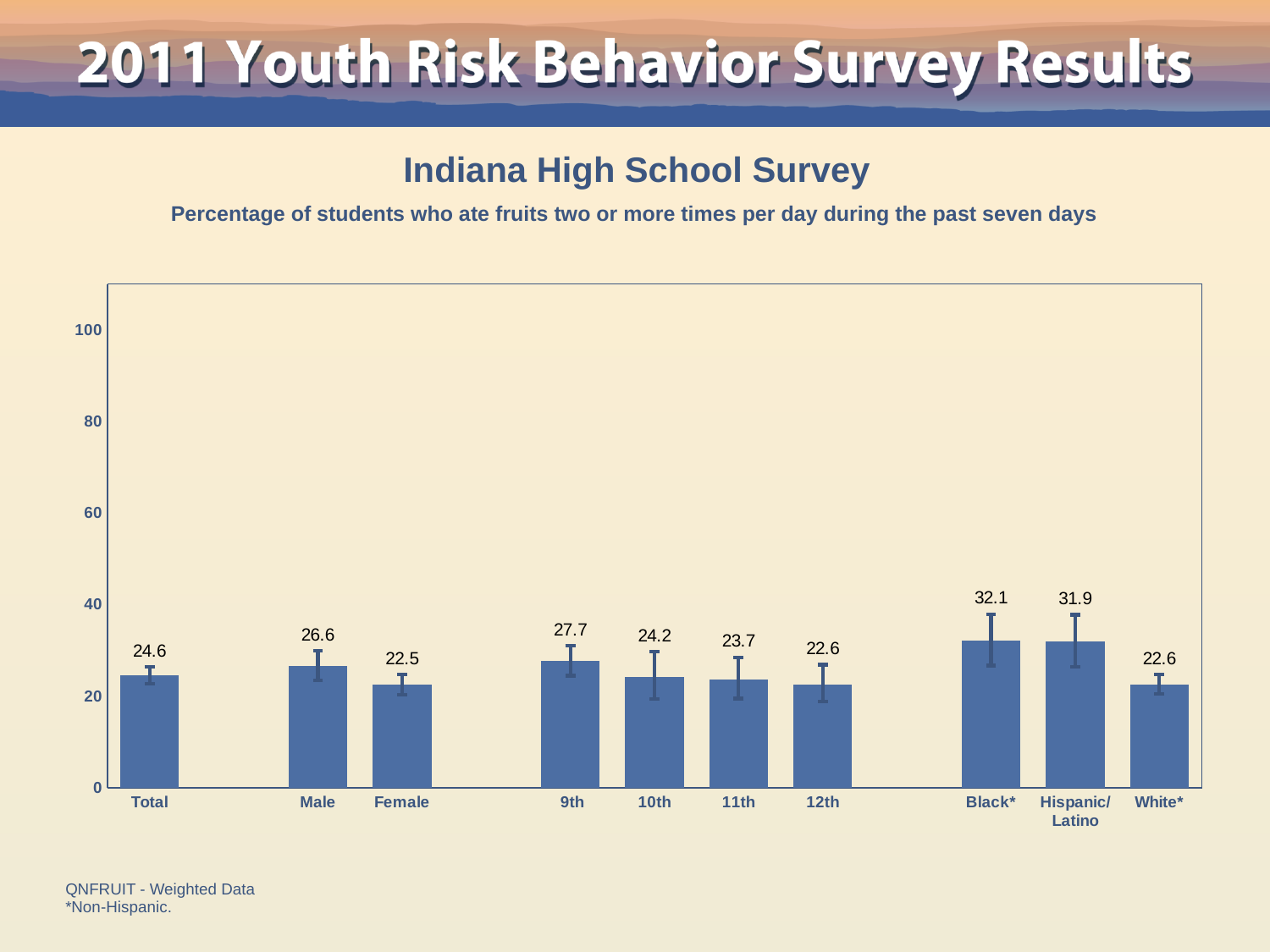
What kind of chart is this? bar chart What is the value for 9th? 27.7 Which is larger, the value for 10th or the value for 11th? 10th Is the value for Black* greater or less than 40? less What is the value for Male? 26.6 Do the values rise or fall from 9th to 12th grade? fall Which category has the highest value? Black* How many categories are shown on the x axis? 10 What is the value for Hispanic/Latino? 31.9 What is the difference between the values for 9th and 12th? 5.1 What is the value for Total? 24.6 What is the difference between the values for Male and Female? 4.1